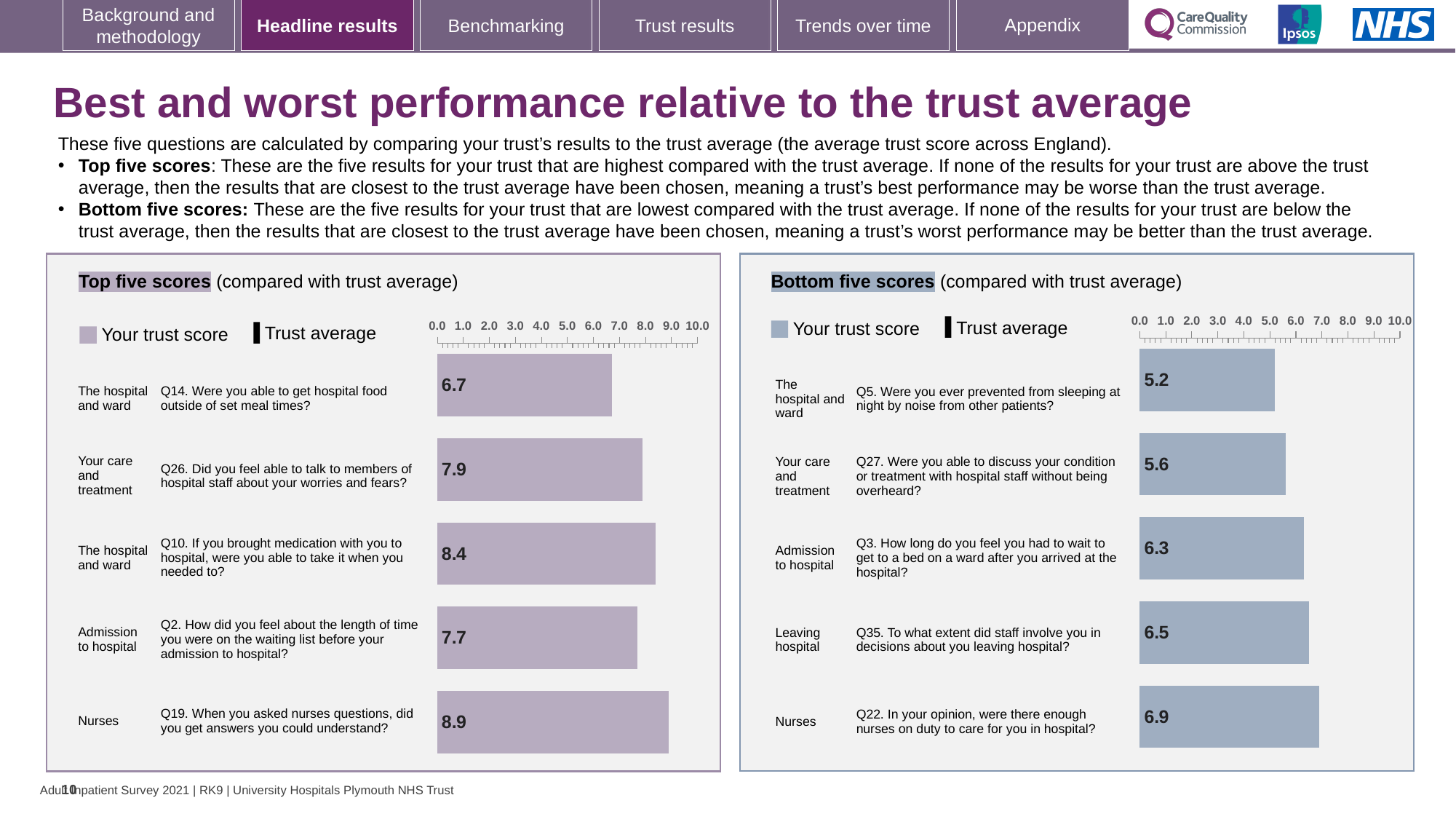
In the Top five scores chart, which has the larger trust score: Q2 or Q26? Q26 In the Bottom five scores chart, what is the difference between the trust scores for Q22 and Q27? 1.3 In the Bottom five scores chart, what is the trust score for Q35 (To what extent did staff involve you in decisions about you leaving hospital?)? 6.5 How many questions are shown in the Bottom five scores chart? 5 In the Top five scores chart, what is the difference between the trust scores for Q10 and Q26? 0.5 In the Top five scores chart, what is the trust score for Q19 (When you asked nurses questions, did you get answers you could understand?)? 8.9 In the Bottom five scores chart, is the trust score for Q3 greater or less than 5.0? greater In the Bottom five scores chart, what is the trust score for Q5 (Were you ever prevented from sleeping at night by noise from other patients?)? 5.2 In the Bottom five scores chart, which question has the lowest trust score? Q5 In the Top five scores chart, which question has the highest trust score? Q19 What type of chart is used in the Top five scores panel? Bar chart In the Top five scores chart, what is the trust score for Q14 (Were you able to get hospital food outside of set meal times?)? 6.7